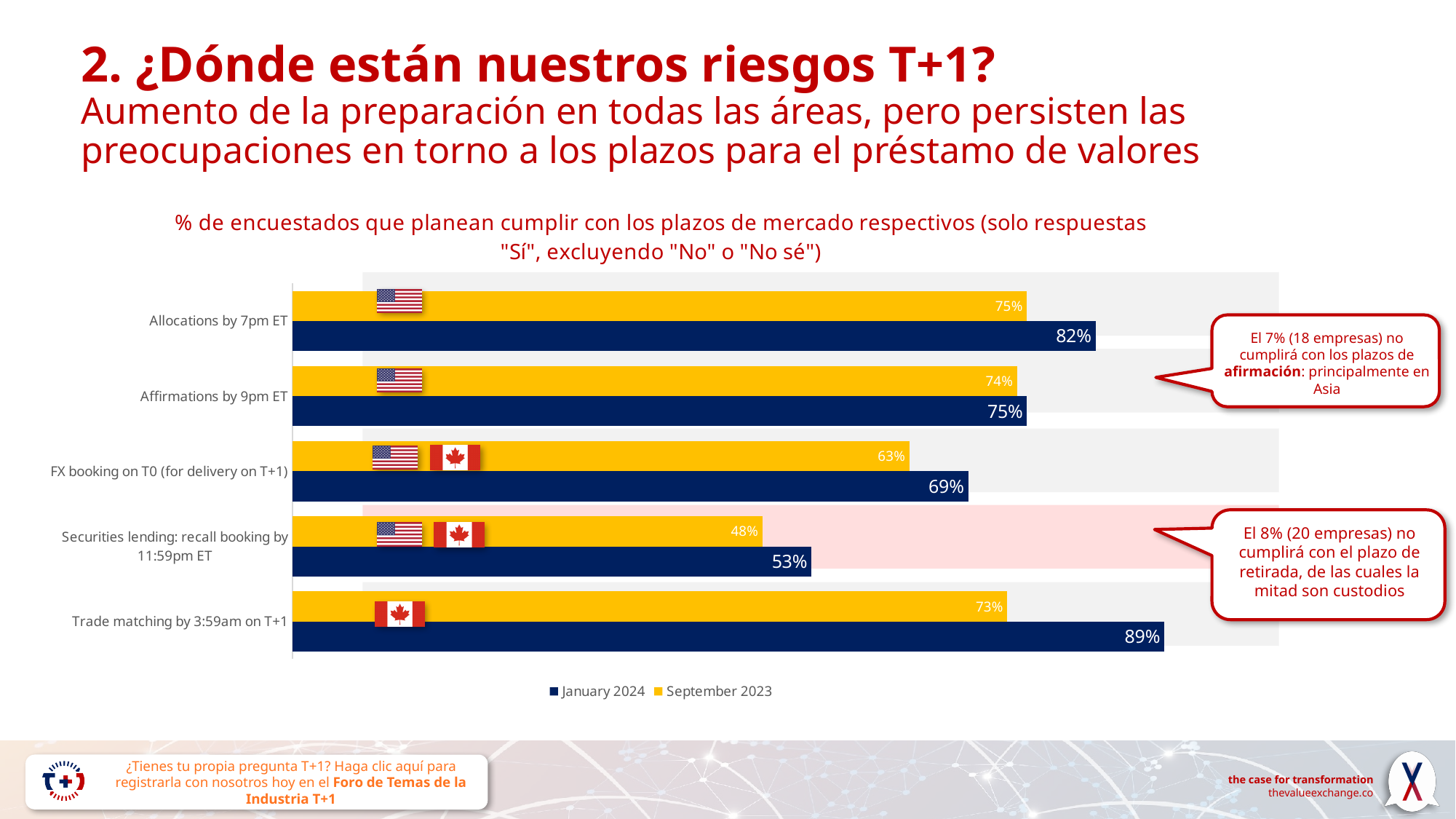
Which colour represents the September 2023 series? Yellow What is the September 2023 value for FX booking on T0 (for delivery on T+1)? 63% How many series does the legend list? 2 What is the January 2024 value for Allocations by 7pm ET? 82% What is the difference between the January 2024 and September 2023 values for Trade matching by 3:59am on T+1? 16% How many categories are shown in the chart? 5 Which is larger for Affirmations by 9pm ET: the January 2024 value or the September 2023 value? January 2024 Which category has the highest January 2024 value? Trade matching by 3:59am on T+1 What is the January 2024 value for Trade matching by 3:59am on T+1? 89% Which category has the lowest September 2023 value? Securities lending: recall booking by 11:59pm ET What is the September 2023 value for Securities lending: recall booking by 11:59pm ET? 48% What kind of chart is shown on the slide? Bar chart